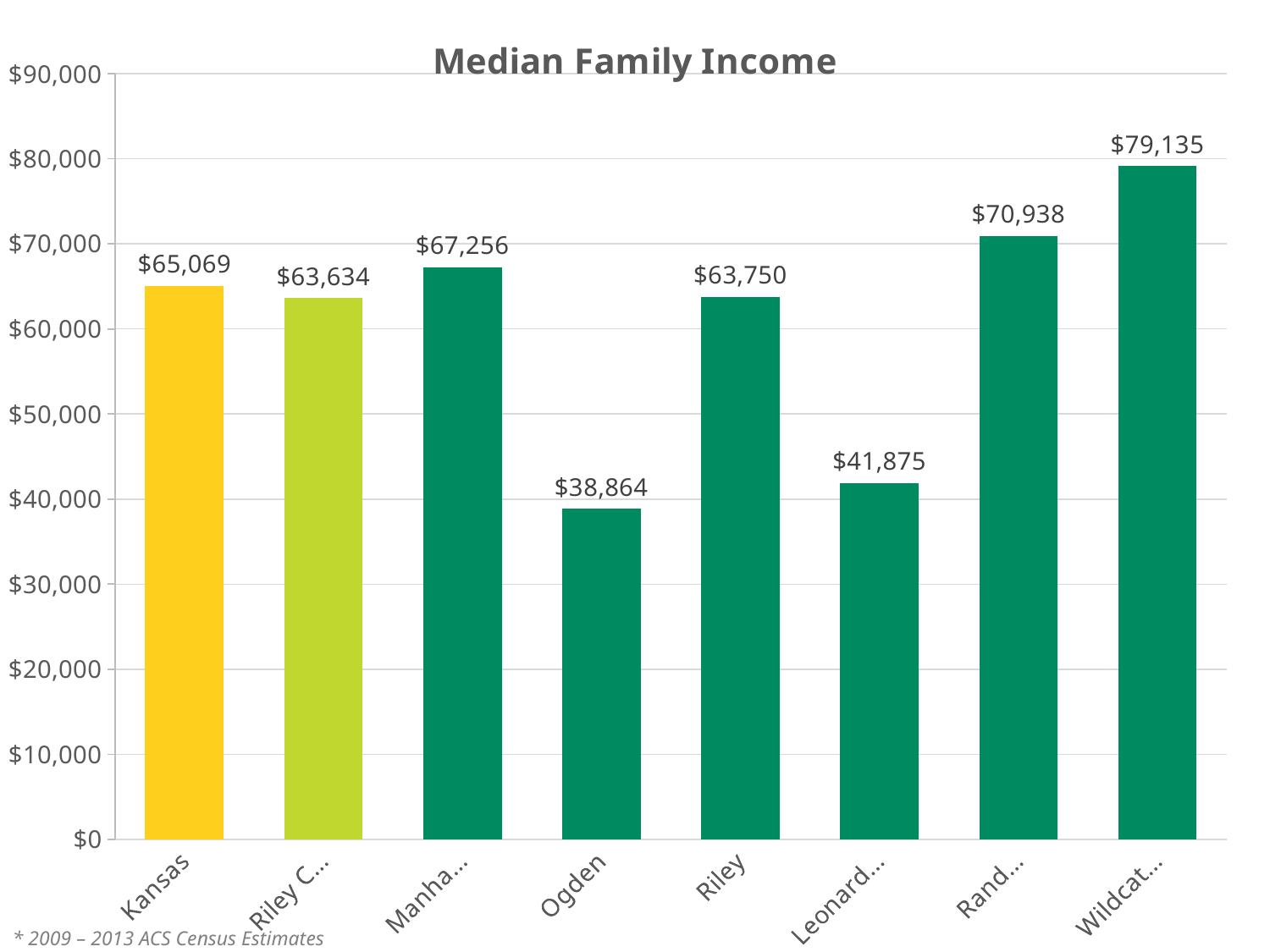
What is the value of the rightmost bar in the chart? $79,135 What is the median family income shown for Ogden? $38,864 What type of chart is shown on the slide? Bar chart Which has a higher median family income, Kansas or Riley? Kansas What is the highest median family income value shown on the chart? $79,135 What is the median family income shown for Riley? $63,750 Which category has the lowest median family income? Ogden What is the median family income shown for Kansas? $65,069 How many bars are shown in the chart? 8 What is the title of the chart? Median Family Income Is the value for Ogden greater or less than $40,000? less How much higher is the median family income for Kansas than for Ogden? $26,205